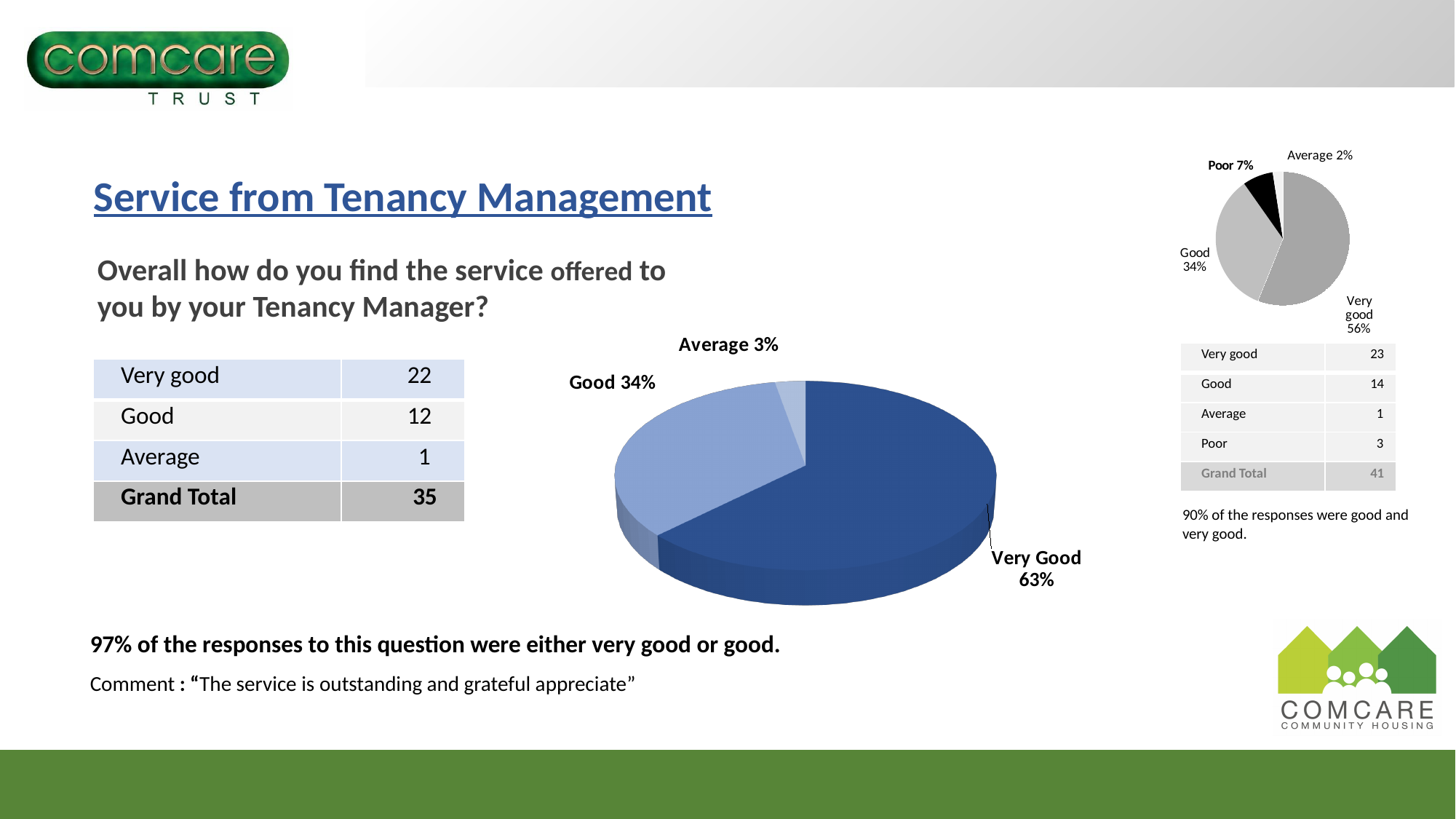
In the small pie chart at the top right of the slide, which category has the smallest slice? Average In the small pie chart at the top right of the slide, what share is labelled for Poor? 7% In the large pie chart in the centre of the slide, what share is labelled for Good? 34% In the small pie chart at the top right of the slide, what is the difference in percentage points between the Very good and Good shares? 22 In the large pie chart in the centre of the slide, what share is labelled for Very Good? 63% How many slices does the small pie chart at the top right of the slide have? 4 In the large pie chart in the centre of the slide, which category has the largest slice? Very Good How many slices does the large pie chart in the centre of the slide have? 3 What kind of chart is the large chart in the centre of the slide? Pie chart In the large pie chart in the centre of the slide, which category has the smallest slice? Average